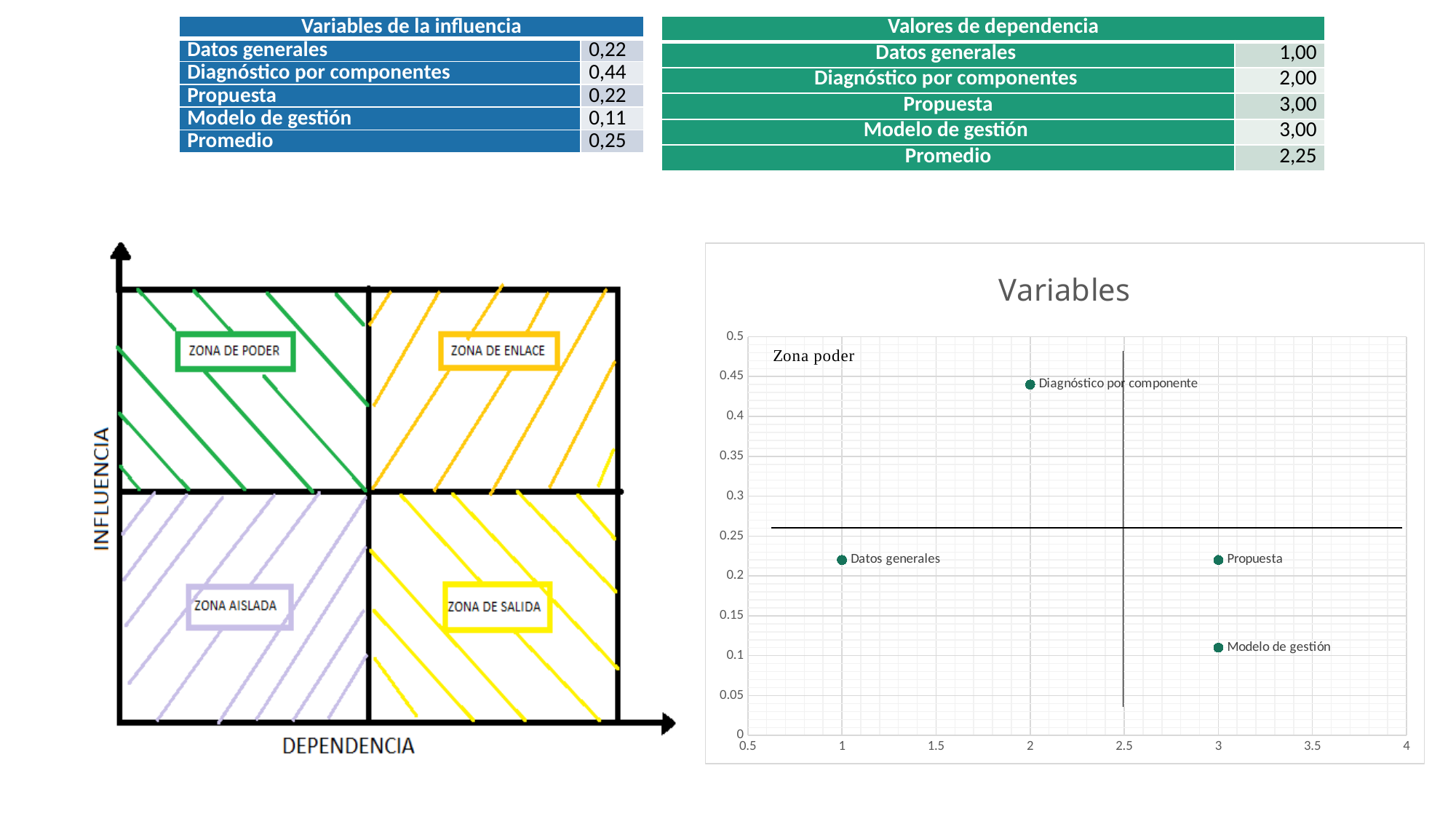
In the "Variables" chart, what is the horizontal-axis value of the point labelled "Diagnóstico por componente"? 2 How many data points are plotted in the "Variables" chart? 4 In the "Variables" chart, which point is higher on the vertical axis, "Propuesta" or "Modelo de gestión"? Propuesta In the "Variables" chart, is the vertical-axis value for "Datos generales" greater or less than 0.25? less In the "Variables" chart, which point has the highest value on the vertical axis? Diagnóstico por componente In the "Variables" chart, what is the horizontal-axis value of the point labelled "Datos generales"? 1 In the "Variables" chart, which point has the lowest value on the vertical axis? Modelo de gestión What is the title of the scatter chart on the right of the slide? Variables What kind of chart is the chart titled "Variables"? scatter chart In the "Variables" chart, what is the horizontal-axis value of the point labelled "Propuesta"? 3 In the "Variables" chart, is the vertical-axis value for "Diagnóstico por componente" greater or less than 0.4? greater In the "Variables" chart, is the vertical-axis value for "Modelo de gestión" greater or less than 0.15? less